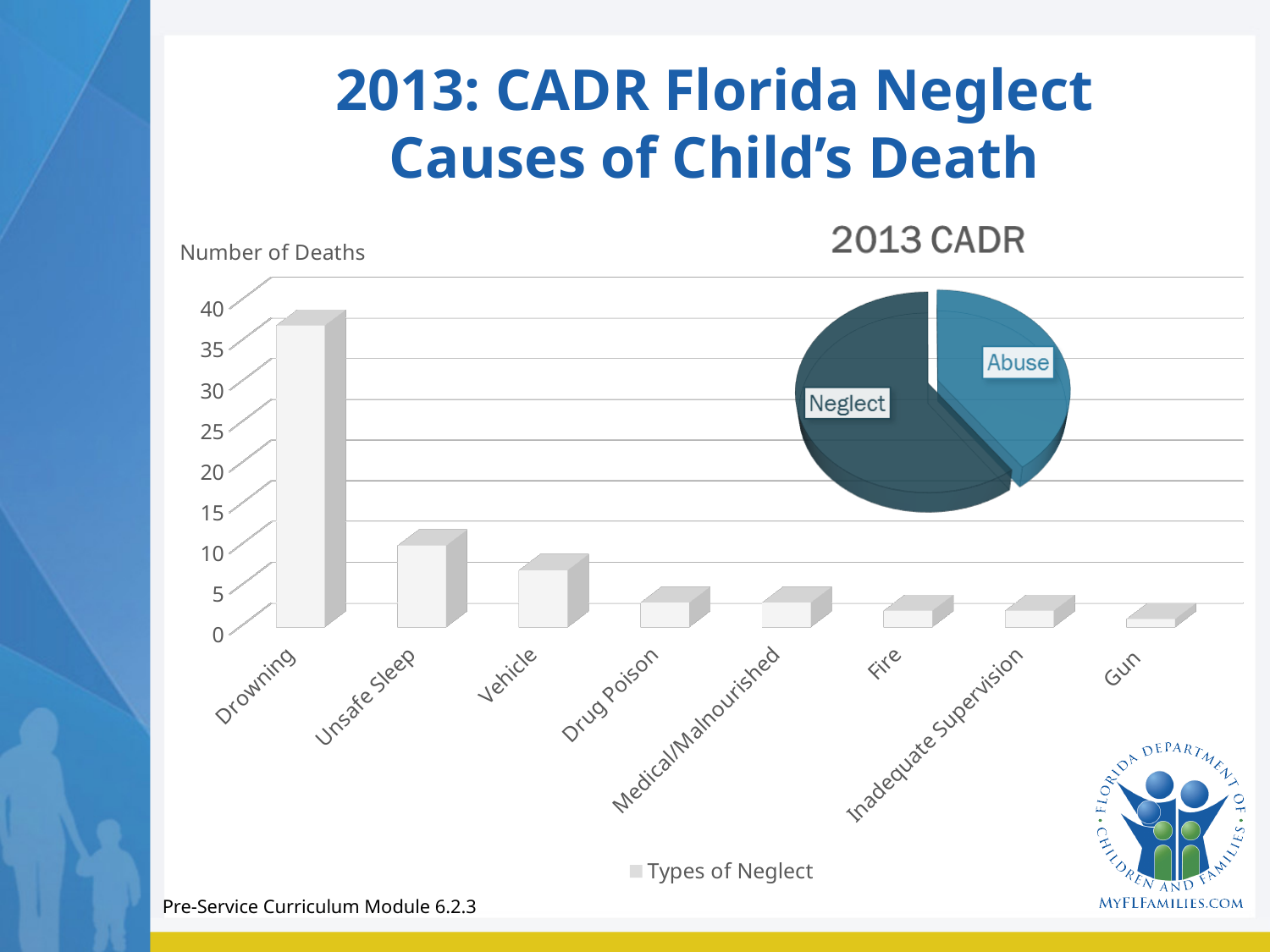
What kind of chart is the chart on the left showing Number of Deaths? Bar chart On the bar chart, is the value for Unsafe Sleep greater or less than 15? less On the bar chart, which is larger, the value for Drowning or the value for Unsafe Sleep? Drowning On the bar chart, is the value for Vehicle greater or less than 10? less On the bar chart, which category has the highest number of deaths? Drowning How many categories are shown on the bar chart? 8 What is the legend entry shown below the bar chart? Types of Neglect On the bar chart, which is larger, the value for Vehicle or the value for Fire? Vehicle On the pie chart titled 2013 CADR, which slice is larger, Neglect or Abuse? Neglect On the bar chart, is the value for Drug Poison greater or less than 5? less How many series does the bar chart's legend list? 1